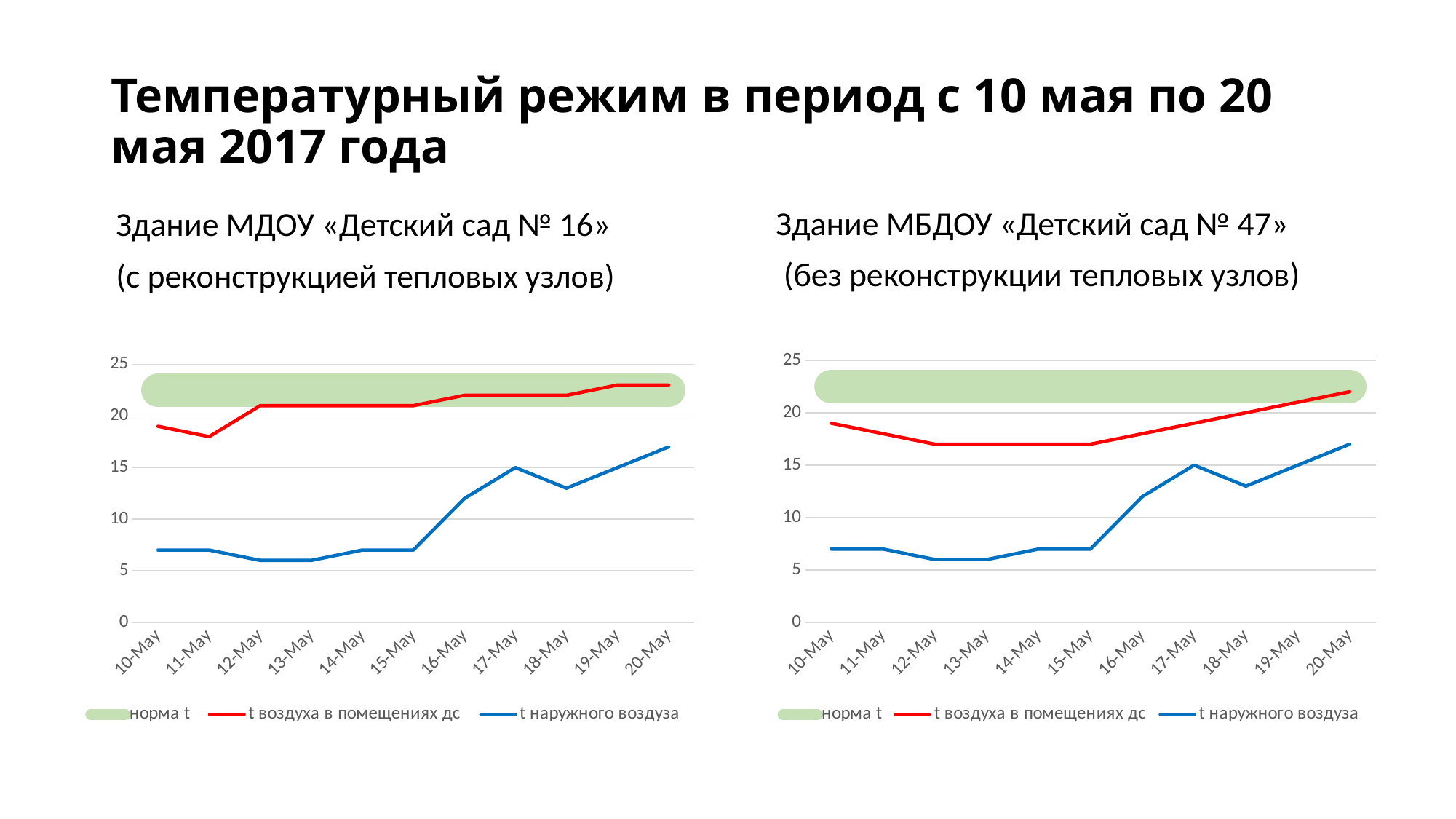
In the left chart («Детский сад № 16»), is the value of «t воздуха в помещениях дс» on 20-May greater or less than 20? greater In the left chart («Детский сад № 16»), does «t наружного воздуза» generally rise or fall from 15-May to 17-May? rise In the right chart («Детский сад № 47»), is the value of «t наружного воздуза» on 20-May greater or less than 15? greater How many series does the legend of the left chart («Детский сад № 16») list? 3 How many dates are shown on the x axis of the right chart («Детский сад № 47»)? 11 In the right chart («Детский сад № 47»), is the value of «t воздуха в помещениях дс» on 13-May greater or less than 20? less In the left chart («Детский сад № 16»), which series has the higher value on 10-May: «t воздуха в помещениях дс» or «t наружного воздуза»? t воздуха в помещениях дс What kind of chart is shown for the building «Детский сад № 16» (left chart)? line chart In the right chart («Детский сад № 47»), does «t воздуха в помещениях дс» rise or fall from 10-May to 12-May? fall In the right chart («Детский сад № 47»), on which date is «t воздуха в помещениях дс» at its highest? 20-May What colour is the «норма t» band in the charts? green